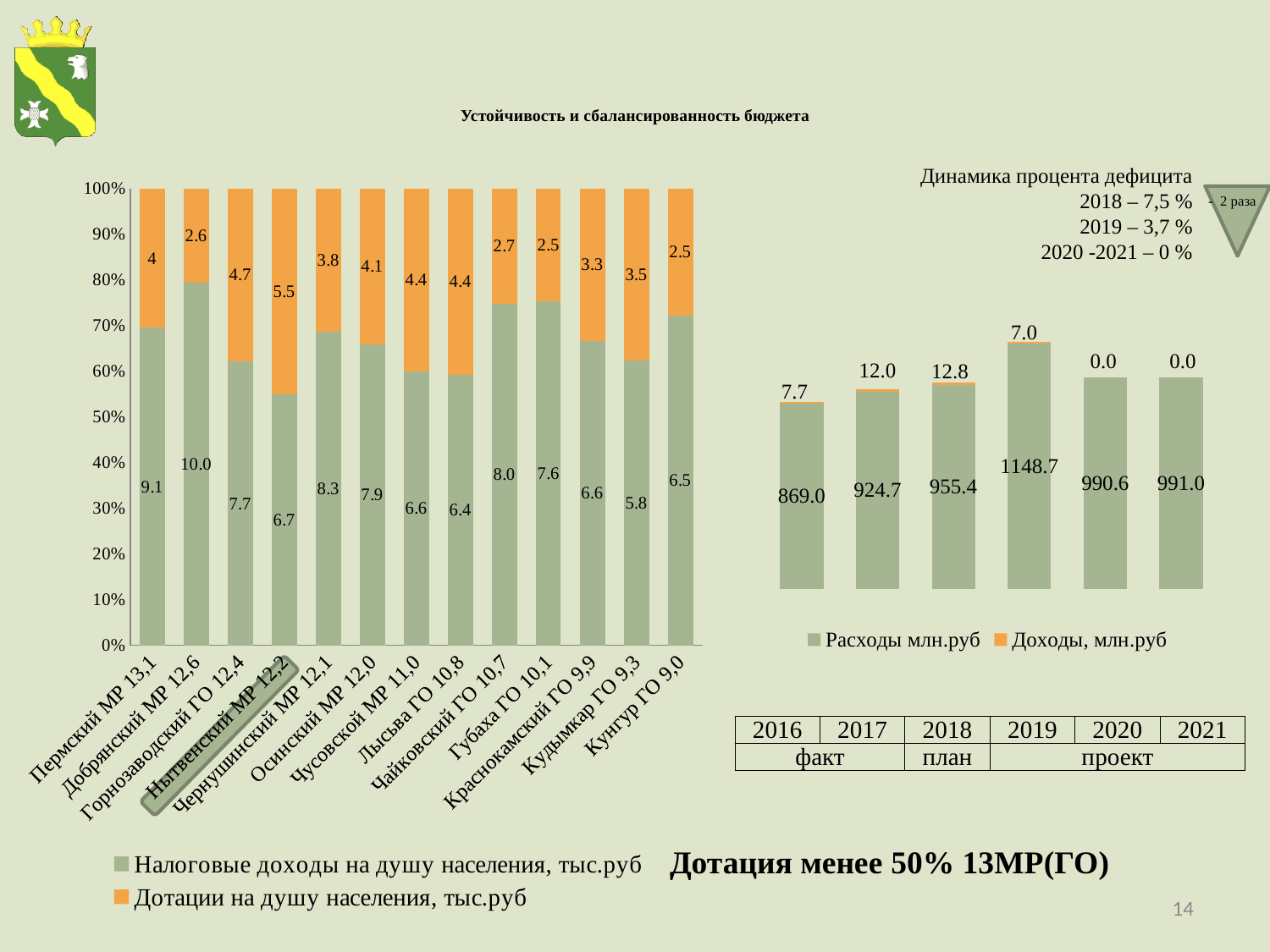
On the right chart, what is the value of Доходы, млн.руб for 2018? 12.8 On the left chart, which category has the lowest value of Налоговые доходы на душу населения? Кудымкар ГО 9,3 On the right chart, is the Расходы value for 2017 larger or smaller than the value for 2018? smaller On the left chart, how many series does the legend list? 2 What kind of chart is the right chart? bar chart On the right chart, which year has the highest value of Расходы млн.руб? 2019 On the left chart, what is the difference between the Налоговые доходы values for Пермский МР 13,1 and Кунгур ГО 9,0? 2.6 On the left chart, how many categories are shown on the x axis? 13 On the left chart, which category has the highest value of Налоговые доходы на душу населения? Добрянский МР 12,6 On the right chart, what is the value of Расходы млн.руб for 2019? 1148.7 On the left chart, what is the value of Налоговые доходы на душу населения for Добрянский МР 12,6? 10.0 On the left chart, what is the value of Дотации на душу населения for Нытвенский МР 12,2? 5.5